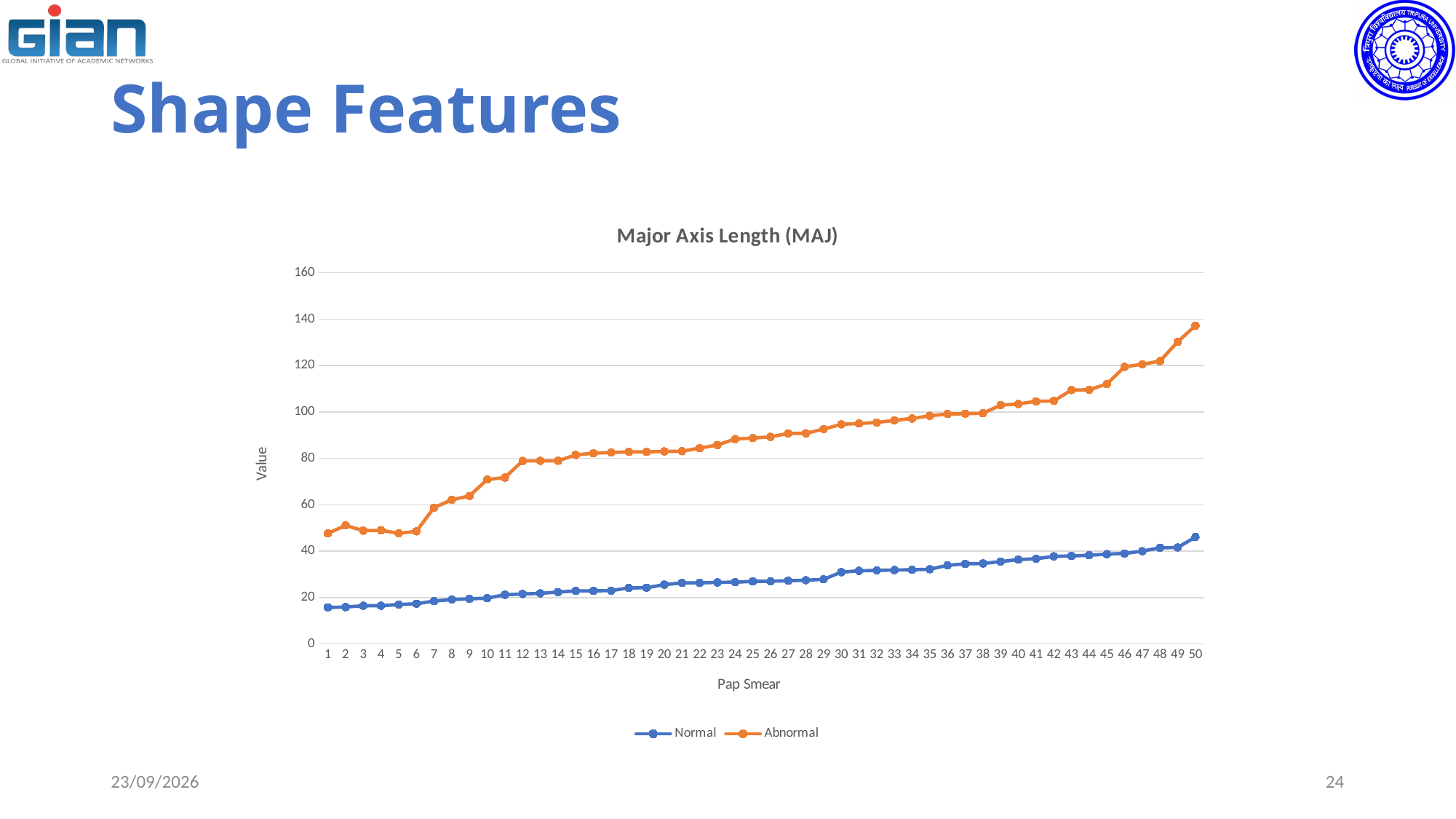
Which pap smear has the highest Abnormal value? 50 What is the title of the chart? Major Axis Length (MAJ) At pap smear 50, which series has the larger value, Normal or Abnormal? Abnormal What is the label of the x axis? Pap Smear Is the Abnormal value for pap smear 50 greater or less than 120? greater What kind of chart is shown on the slide? line chart Is the Abnormal value for pap smear 25 greater or less than 80? greater Is the Normal value for pap smear 50 greater or less than 60? less How many series does the legend list? 2 How many pap smear points are plotted along the x axis? 50 Do the Normal values rise or fall from pap smear 1 to pap smear 50? rise Do the Abnormal values rise or fall from pap smear 1 to pap smear 50? rise